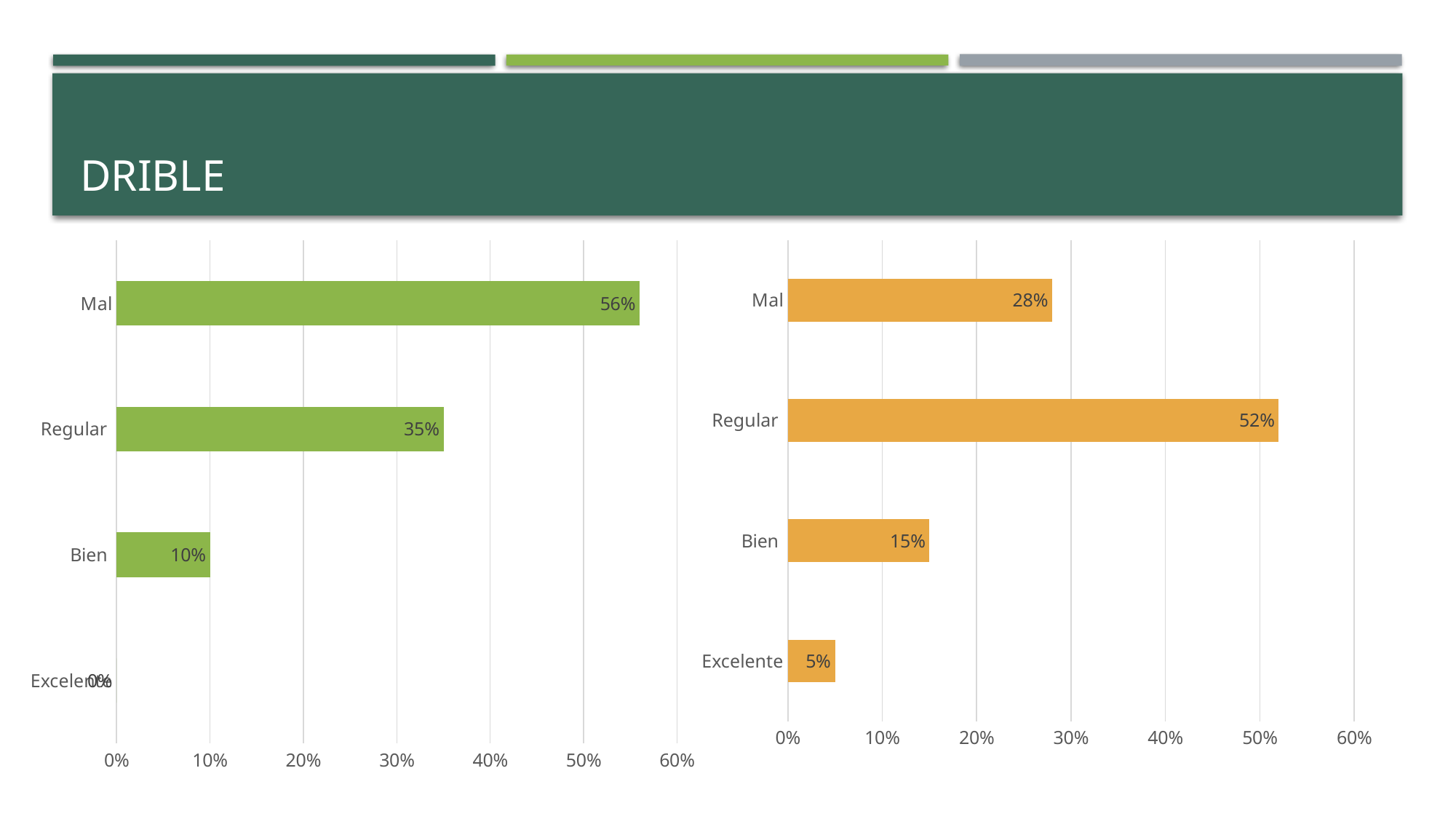
In the left (green) chart, is the value for Regular greater or less than 30%? greater In the left (green) chart, which category has the highest value? Mal In the right (orange) chart, what is the value for Regular? 52% In the right (orange) chart, what is the difference between Regular and Mal? 24% In the right (orange) chart, which is larger, Mal or Bien? Mal In the right (orange) chart, what is the value for Excelente? 5% How many categories does the right (orange) chart show? 4 In the left (green) chart, what is the difference between Mal and Regular? 21% What kind of chart is the left (green) chart? bar chart In the left (green) chart, what is the value for Bien? 10% In the right (orange) chart, which category has the lowest value? Excelente In the left (green) chart, what is the value for Mal? 56%